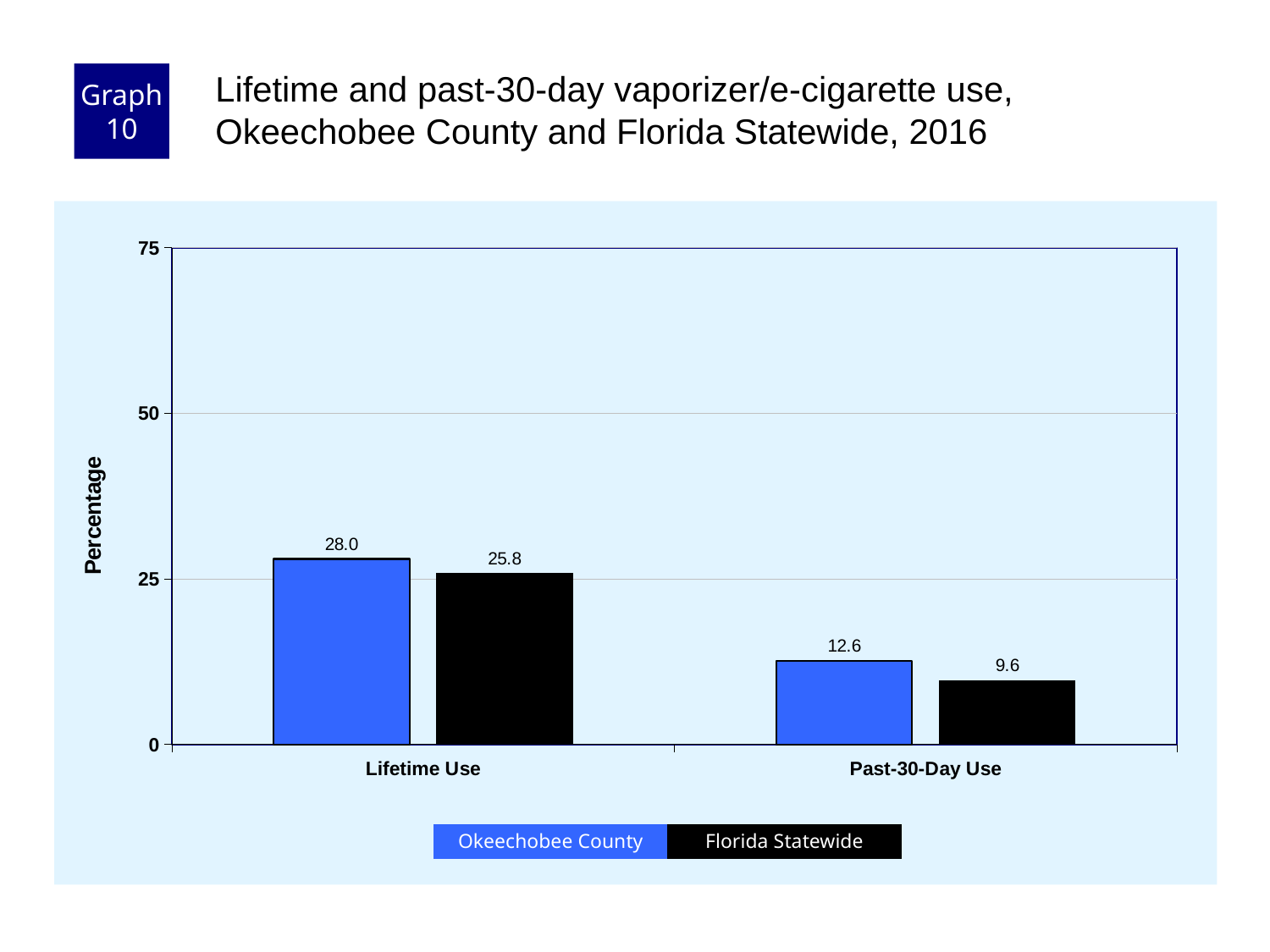
Which is larger for Past-30-Day Use: Okeechobee County or Florida Statewide? Okeechobee County What is the difference between the Okeechobee County and Florida Statewide values for Past-30-Day Use? 3.0 How many series does the legend list? 2 How many categories are shown on the x axis? 2 What is the difference between the Okeechobee County and Florida Statewide values for Lifetime Use? 2.2 Which category has the highest Okeechobee County value? Lifetime Use What type of chart is shown on the slide? Bar chart What is the Florida Statewide value for Lifetime Use? 25.8 What is the Okeechobee County value for Lifetime Use? 28.0 What is the Florida Statewide value for Past-30-Day Use? 9.6 Is the Okeechobee County value for Lifetime Use greater or less than 25? greater Which series has the lowest value for Past-30-Day Use? Florida Statewide